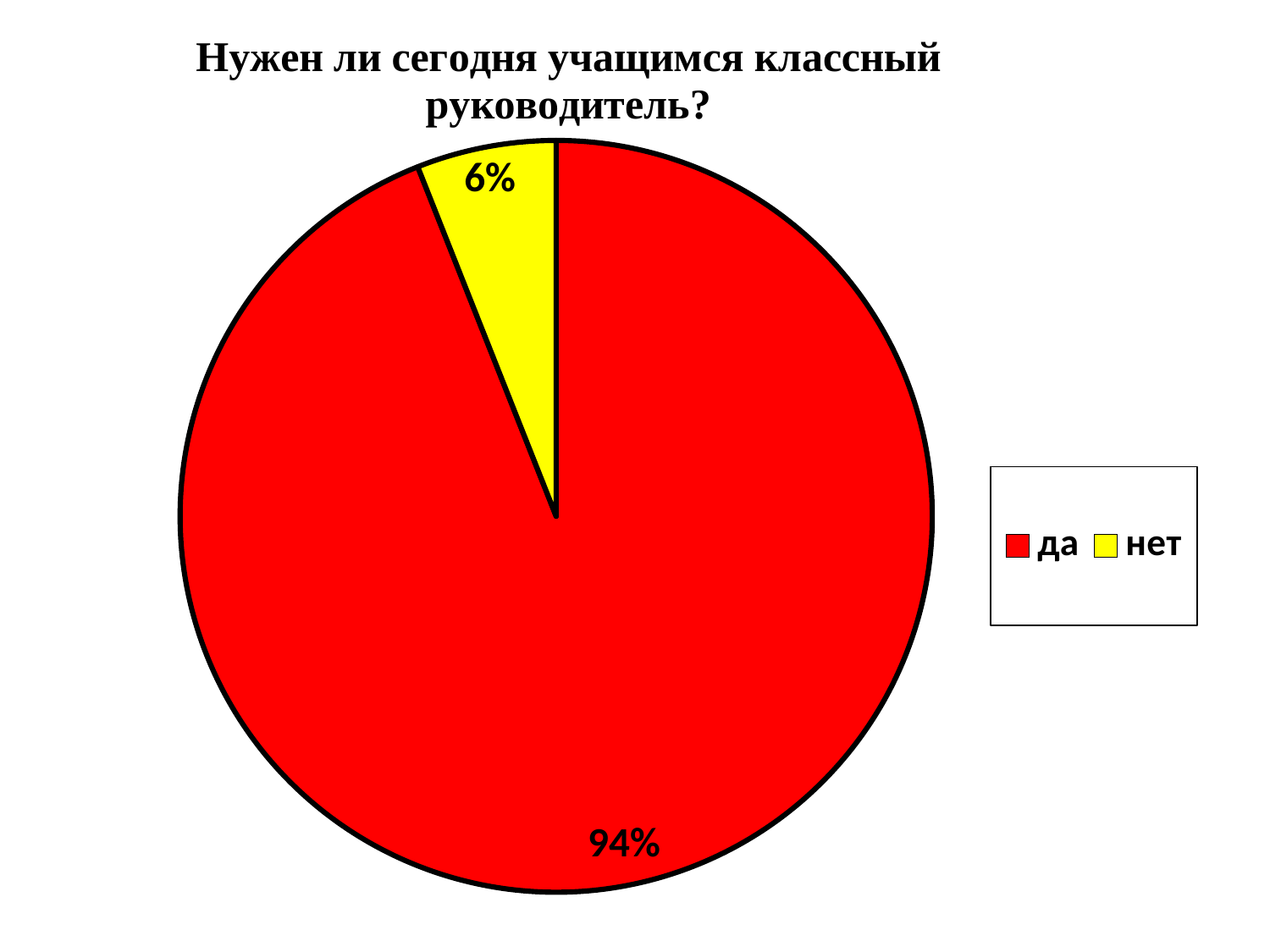
What kind of chart is shown on the slide? pie chart What share of the pie does "нет" take? 6% How many entries does the legend list? 2 Which slice is larger, "да" or "нет"? да What is the title of the chart? Нужен ли сегодня учащимся классный руководитель? Which category has the largest slice of the pie? да What colour is the "нет" slice? yellow What is the difference in percentage points between the "да" and "нет" slices? 88 How many categories does the pie chart have? 2 What share of the pie does "да" take? 94% Which category has the smallest slice of the pie? нет